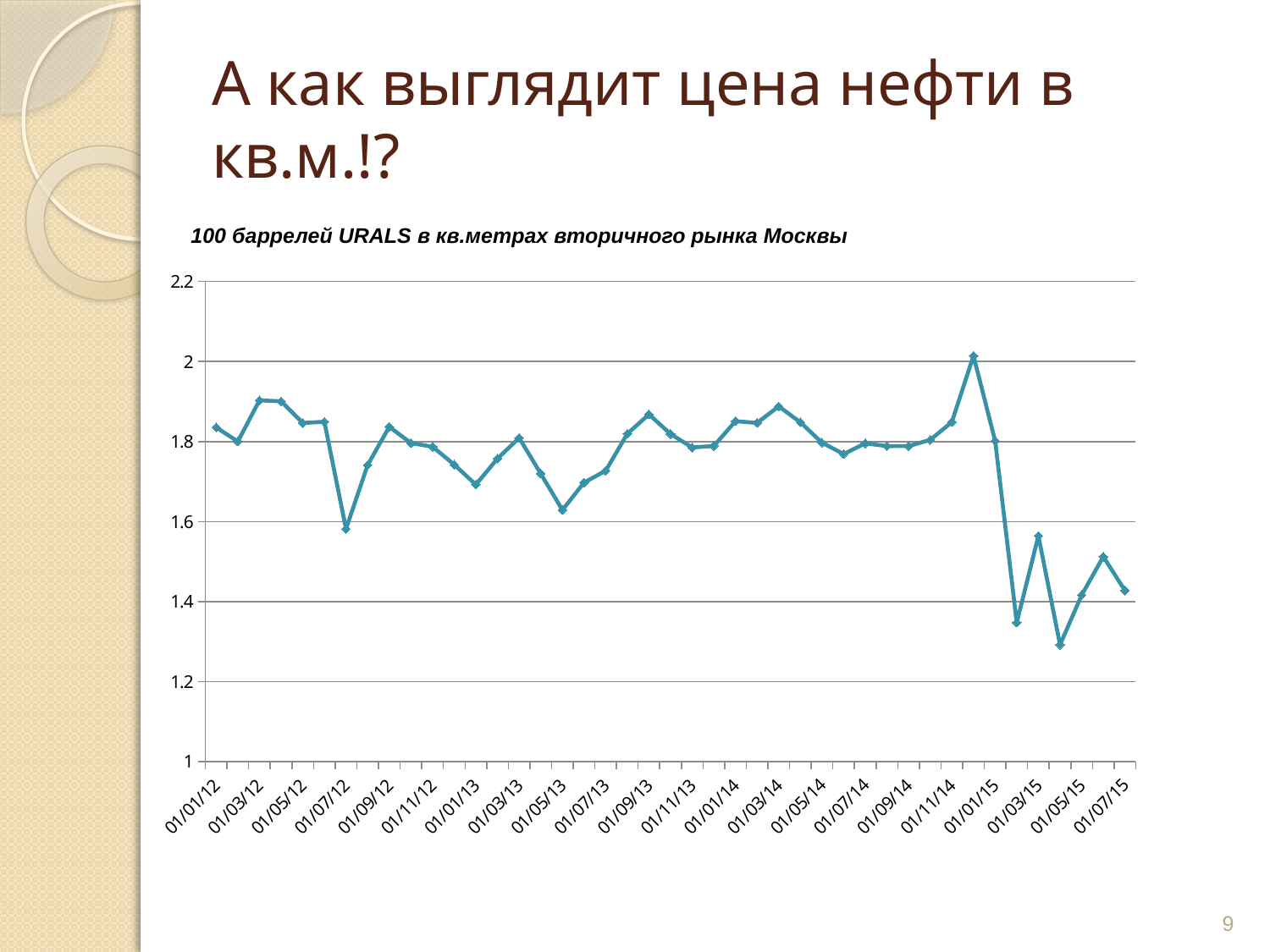
Which is larger, the value for 01/03/12 or the value for 01/07/12? 01/03/12 Is the value for 01/03/12 greater or less than 1.8? greater Overall, does the line rise or fall from 01/01/12 to 01/07/15? Fall Is the value for 01/03/14 greater or less than 1.8? greater What is the title of the chart? 100 баррелей URALS в кв.метрах вторичного рынка Москвы Which is larger, the value for 01/03/15 or the value for 01/05/15? 01/03/15 What kind of chart is shown on the slide? Line chart Is the value for 01/01/12 greater or less than 1.6? greater What is the highest value shown on the y axis? 2.2